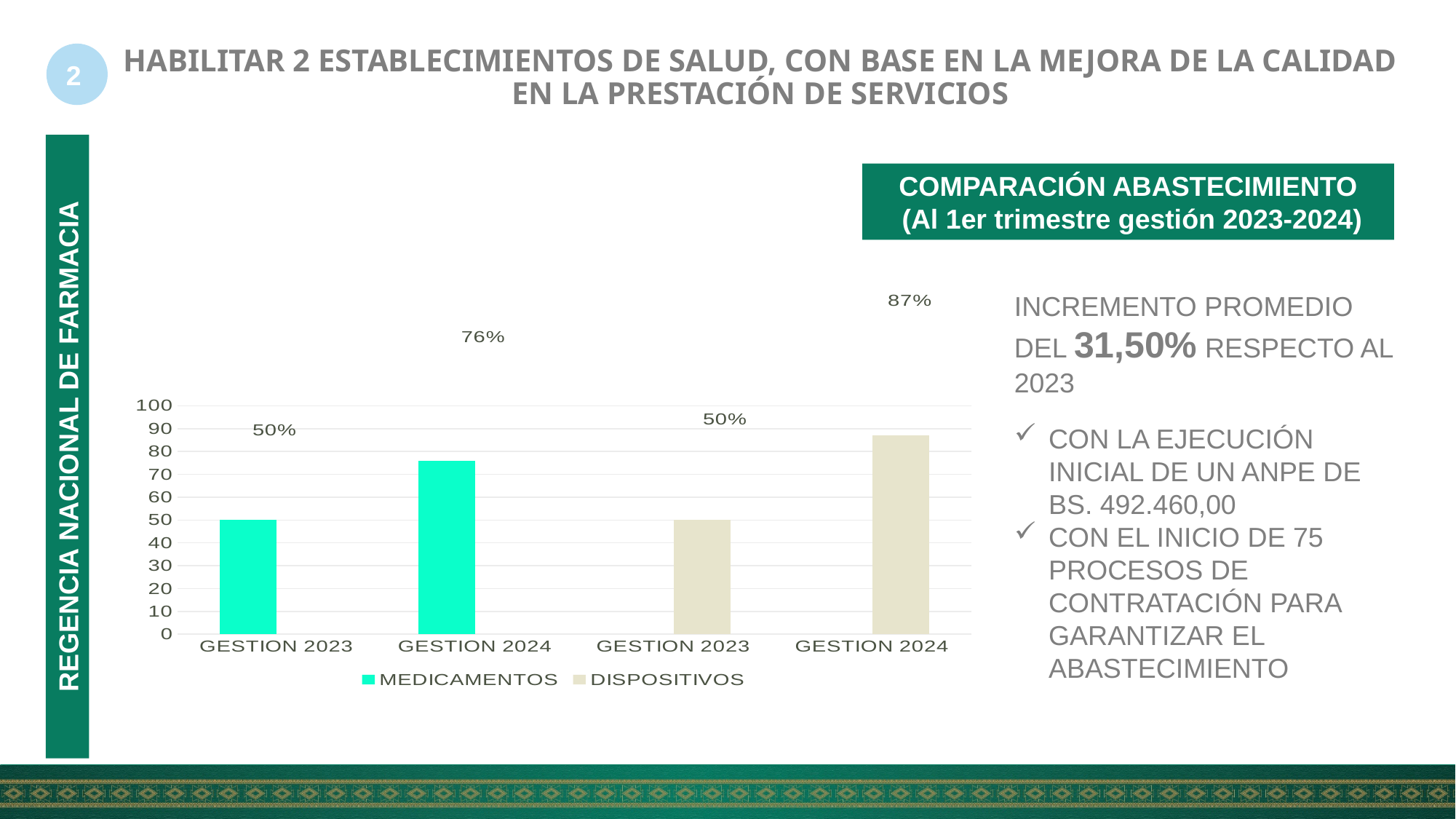
What is the value for MEDICAMENTOS in GESTION 2024? 76% What is the value for DISPOSITIVOS in GESTION 2023? 50% Which bar has the highest value in the chart? DISPOSITIVOS GESTION 2024 How many series does the legend list? 2 Which is larger in GESTION 2024: MEDICAMENTOS or DISPOSITIVOS? DISPOSITIVOS Is the value for MEDICAMENTOS in GESTION 2024 greater or less than 70? greater What is the difference between the DISPOSITIVOS value in GESTION 2024 and in GESTION 2023? 37% What is the value for MEDICAMENTOS in GESTION 2023? 50% What is the value for DISPOSITIVOS in GESTION 2024? 87% How many bars are plotted in the chart? 4 What is the difference between the MEDICAMENTOS value in GESTION 2024 and in GESTION 2023? 26% What kind of chart is shown on the slide? Bar chart